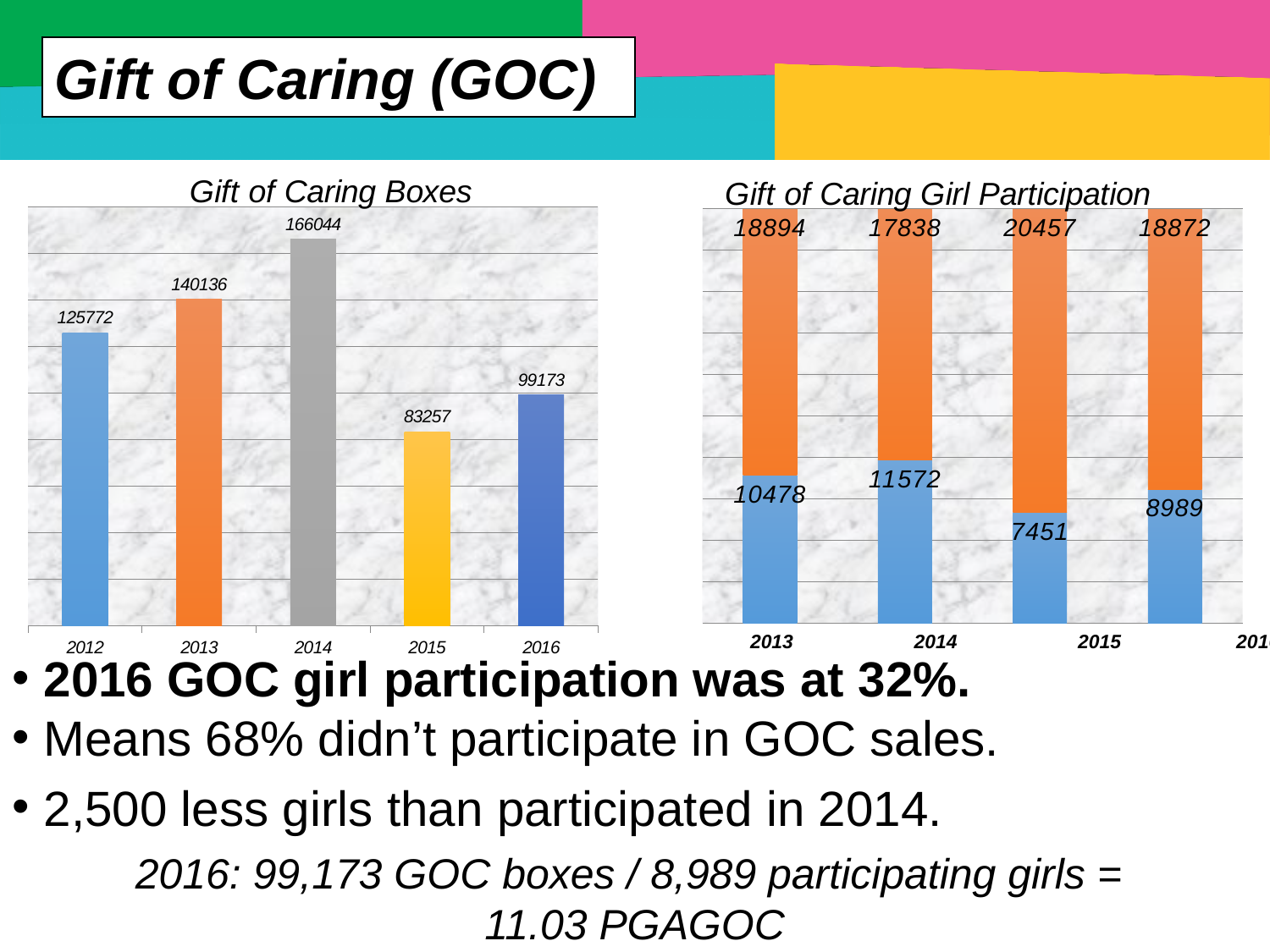
In the Gift of Caring Girl Participation chart, which year has the largest blue segment? 2014 In the Gift of Caring Girl Participation chart, what is the total of the stacked bar for 2014? 29410 How many years are shown in the Gift of Caring Boxes chart? 5 What kind of chart is the Gift of Caring Boxes chart? bar chart In the Gift of Caring Girl Participation chart, what is the value of the orange segment for 2013? 18894 In the Gift of Caring Boxes chart, which year has the highest value? 2014 What is the title of the chart on the right side of the slide? Gift of Caring Girl Participation In the Gift of Caring Boxes chart, what is the difference between the 2013 and 2012 values? 14364 In the Gift of Caring Boxes chart, which is larger, the value for 2016 or the value for 2015? 2016 In the Gift of Caring Boxes chart, how many boxes were there in 2014? 166044 In the Gift of Caring Boxes chart, which year has the lowest value? 2015 In the Gift of Caring Girl Participation chart, what is the value of the blue segment for 2015? 7451